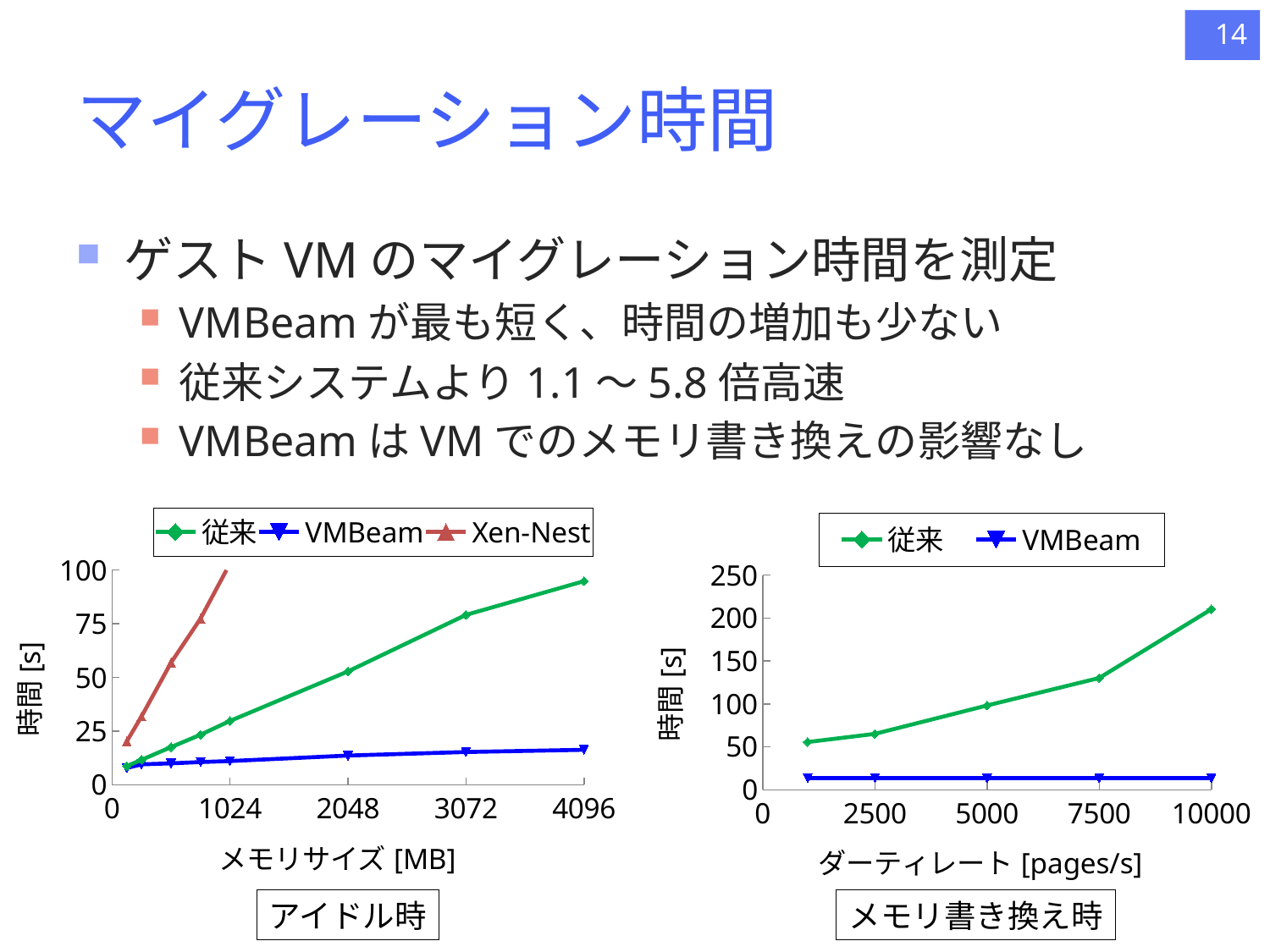
What kind of chart is the left chart (アイドル時)? line chart In the left chart (アイドル時), which series has the highest value at 1024 MB? Xen-Nest In the left chart (アイドル時), is the value for 従来 at 4096 MB greater or less than 75? greater In the left chart (アイドル時), is the value for VMBeam at 4096 MB greater or less than 25? less In the left chart (アイドル時), is the value for Xen-Nest at 512 MB greater or less than 50? greater In the right chart (メモリ書き換え時), does the 従来 series rise or fall as the dirty rate increases? rise How many series does the legend of the left chart (アイドル時) list? 3 In the left chart (アイドル時), which is larger at 4096 MB, 従来 or VMBeam? 従来 In the right chart (メモリ書き換え時), how many data points does the 従来 series have? 5 How many series does the legend of the right chart (メモリ書き換え時) list? 2